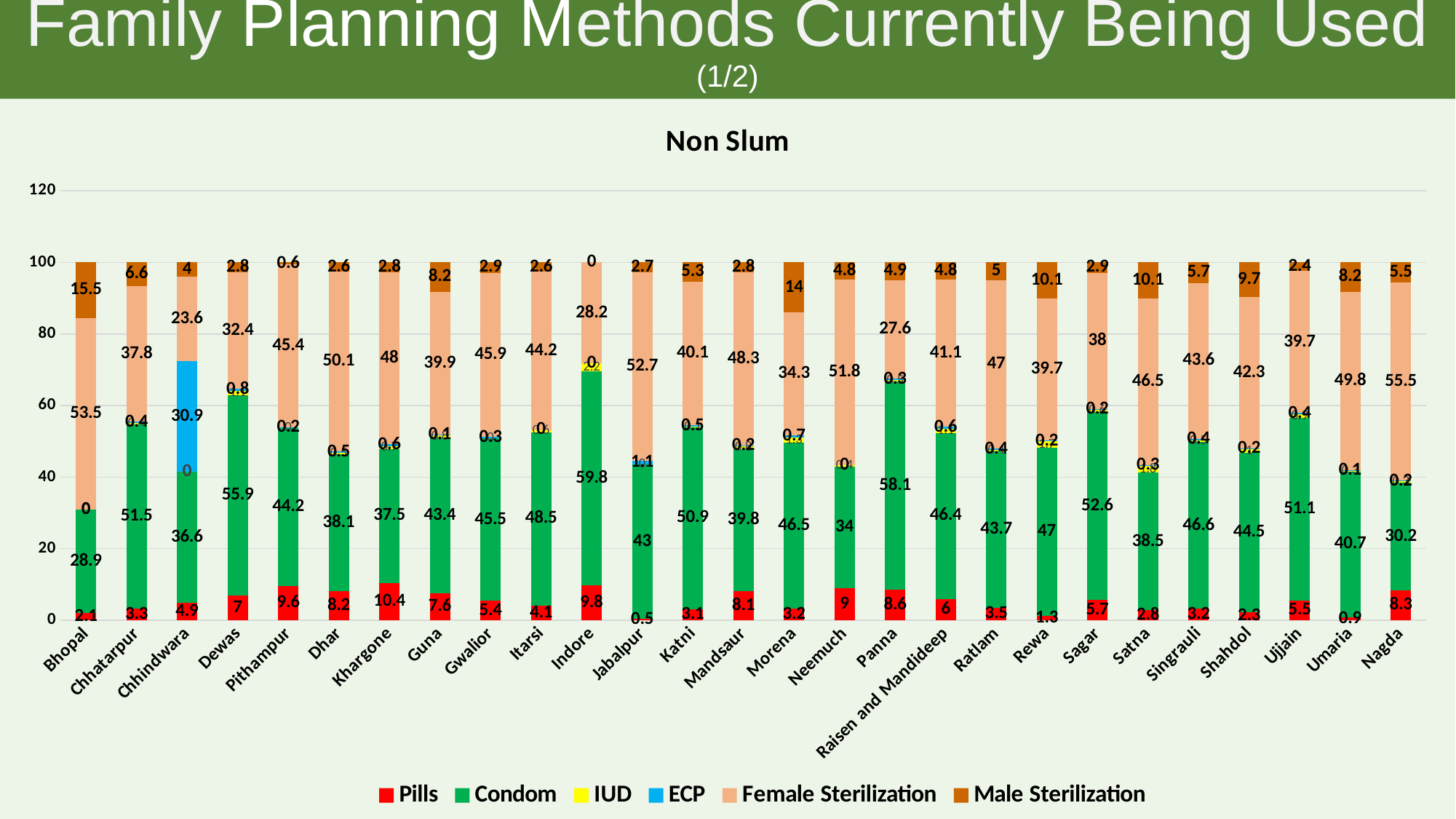
Which is larger, the Condom value for Panna or the Condom value for Dewas? Panna How many series does the legend list? 6 What is the difference between the Female Sterilization values for Bhopal and Chhatarpur? 15.7 Which city has the highest Male Sterilization value? Bhopal Which city has the highest Pills value? Khargone What type of chart is shown on the slide? Stacked bar chart What is the ECP value for Chhindwara? 30.9 What is the Male Sterilization value for Morena? 14 What is the Female Sterilization value for Nagda? 55.5 Which city has the lowest Pills value? Jabalpur What is the Condom value for Indore? 59.8 How many cities are shown on the x axis? 27